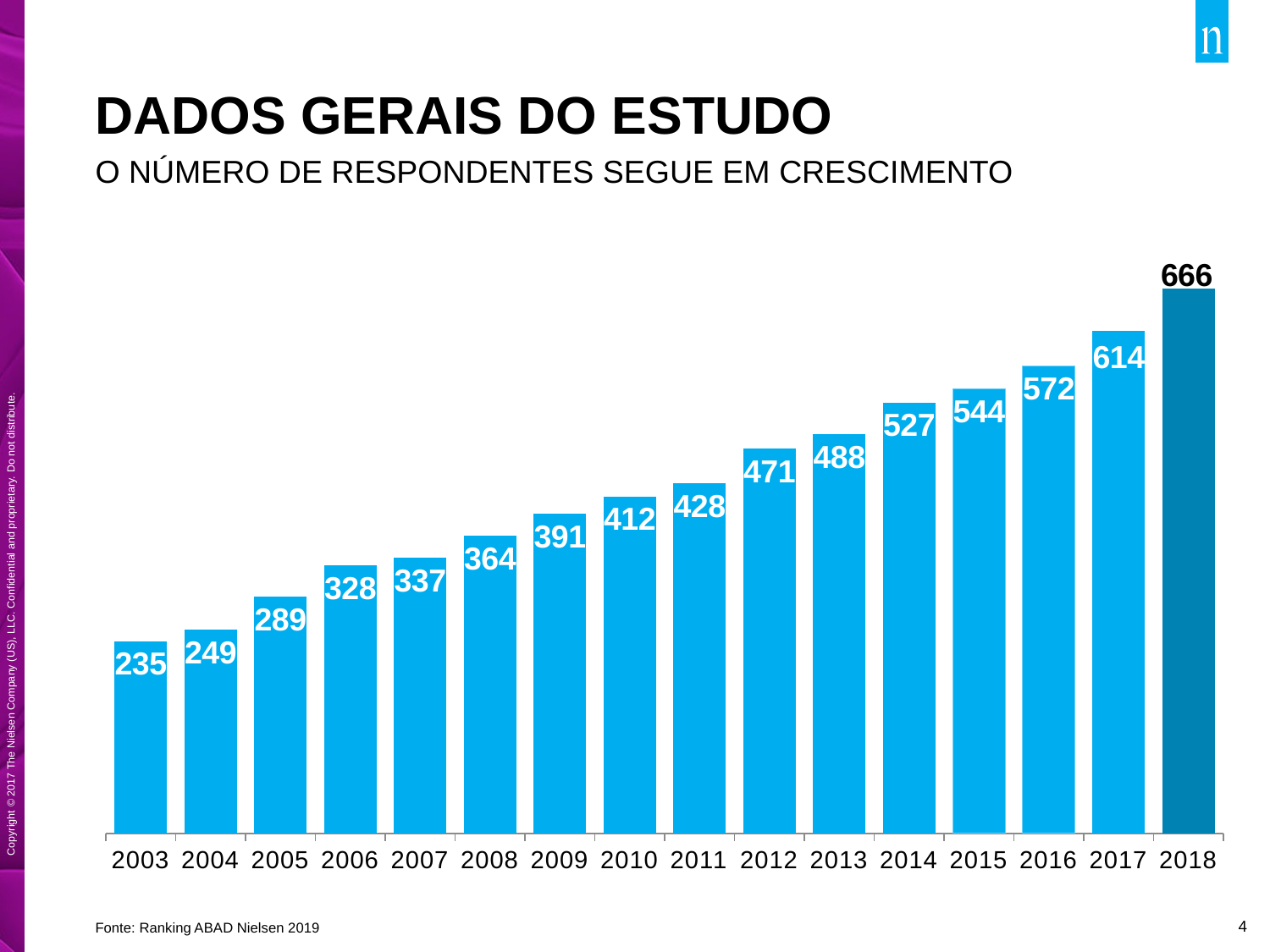
What is the difference between the values for 2013 and 2012? 17 What kind of chart is shown on the slide? Bar chart Do the values rise or fall from 2003 to 2018? Rise What value is shown for 2003? 235 What is the difference between the values for 2018 and 2017? 52 Which bar is shown in a darker shade of blue than the others? 2018 What is the number of respondents shown for 2018? 666 Which year has the lowest value? 2003 Which is larger, the value for 2006 or the value for 2007? 2007 Which year has the highest value? 2018 What value is shown for 2010? 412 How many years are shown on the x axis? 16